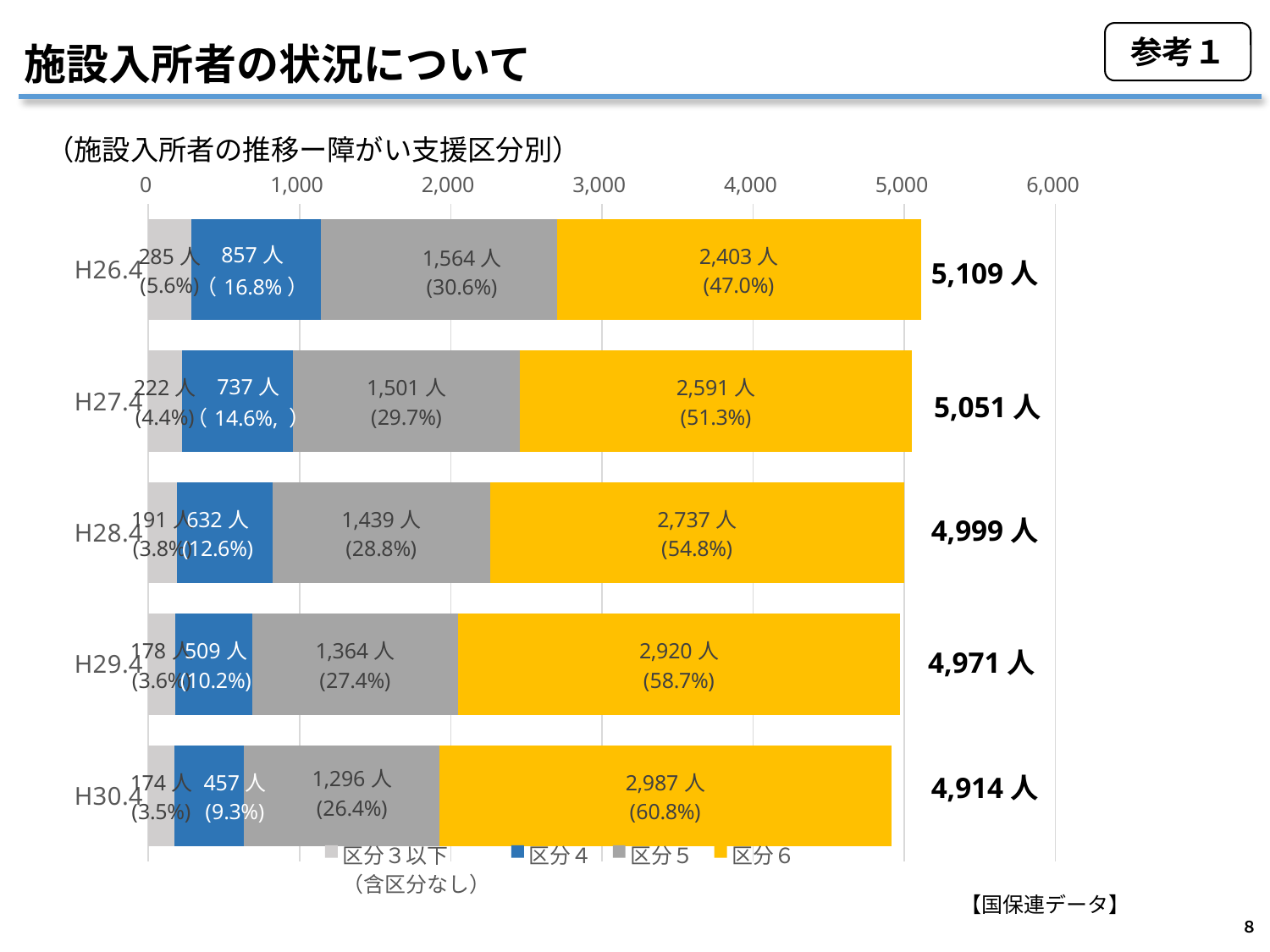
How many series does the legend list? 4 How does the total number of facility residents change from H26.4 to H30.4? It decreases What kind of chart is shown on the slide? Stacked bar chart What is the difference between the 区分６ values for H30.4 and H26.4? 584 人 Which period has the highest total number of facility residents? H26.4 Which is larger: the 区分５ value in H26.4 or the 区分５ value in H30.4? H26.4 What is the total number of facility residents shown for H27.4? 5,051 人 What percentage share does 区分５ have in H28.4? 28.8% Which period has the lowest value for 区分３以下（含区分なし）? H30.4 What is the value for 区分６ in H30.4? 2,987 人 What is the value for 区分４ in H26.4? 857 人 How many time periods (categories) are plotted on the chart? 5